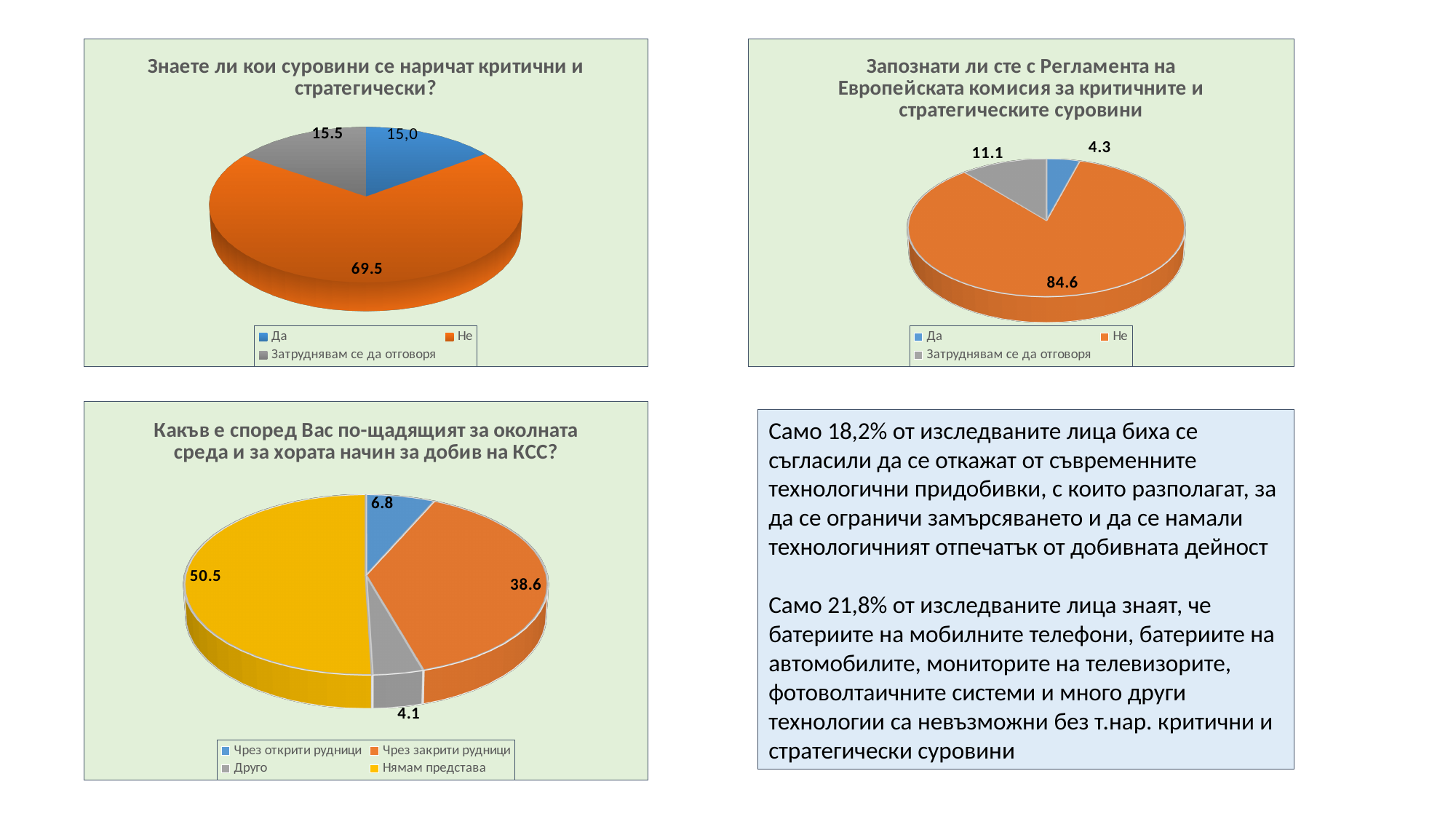
In the top-right chart ("Запознати ли сте с Регламента на Европейската комисия..."), which category has the smallest slice? Да In the top-right chart ("Запознати ли сте с Регламента на Европейската комисия..."), what is the difference between the values for "Не" and "Да"? 80.3 In the top-left chart ("Знаете ли кои суровини се наричат критични и стратегически?"), which category has the largest slice? Не In the top-left chart ("Знаете ли кои суровини се наричат критични и стратегически?"), what colour is the "Затруднявам се да отговоря" slice? Grey In the top-right chart ("Запознати ли сте с Регламента на Европейската комисия..."), what is the value for "Затруднявам се да отговоря"? 11.1 How many categories does the bottom-left chart ("Какъв е според Вас по-щадящият...") show? 4 In the bottom-left chart ("Какъв е според Вас по-щадящият..."), which is larger: "Чрез открити рудници" or "Друго"? Чрез открити рудници What kind of chart is the top-right chart ("Запознати ли сте с Регламента на Европейската комисия...")? Pie chart In the top-left chart ("Знаете ли кои суровини се наричат критични и стратегически?"), what is the value for "Не"? 69.5 In the bottom-left chart ("Какъв е според Вас по-щадящият..."), what is the value for "Чрез закрити рудници"? 38.6 In the top-left chart ("Знаете ли кои суровини се наричат критични и стратегически?"), what is the value for "Да"? 15,0 In the bottom-left chart ("Какъв е според Вас по-щадящият..."), which category has the largest slice? Нямам представа